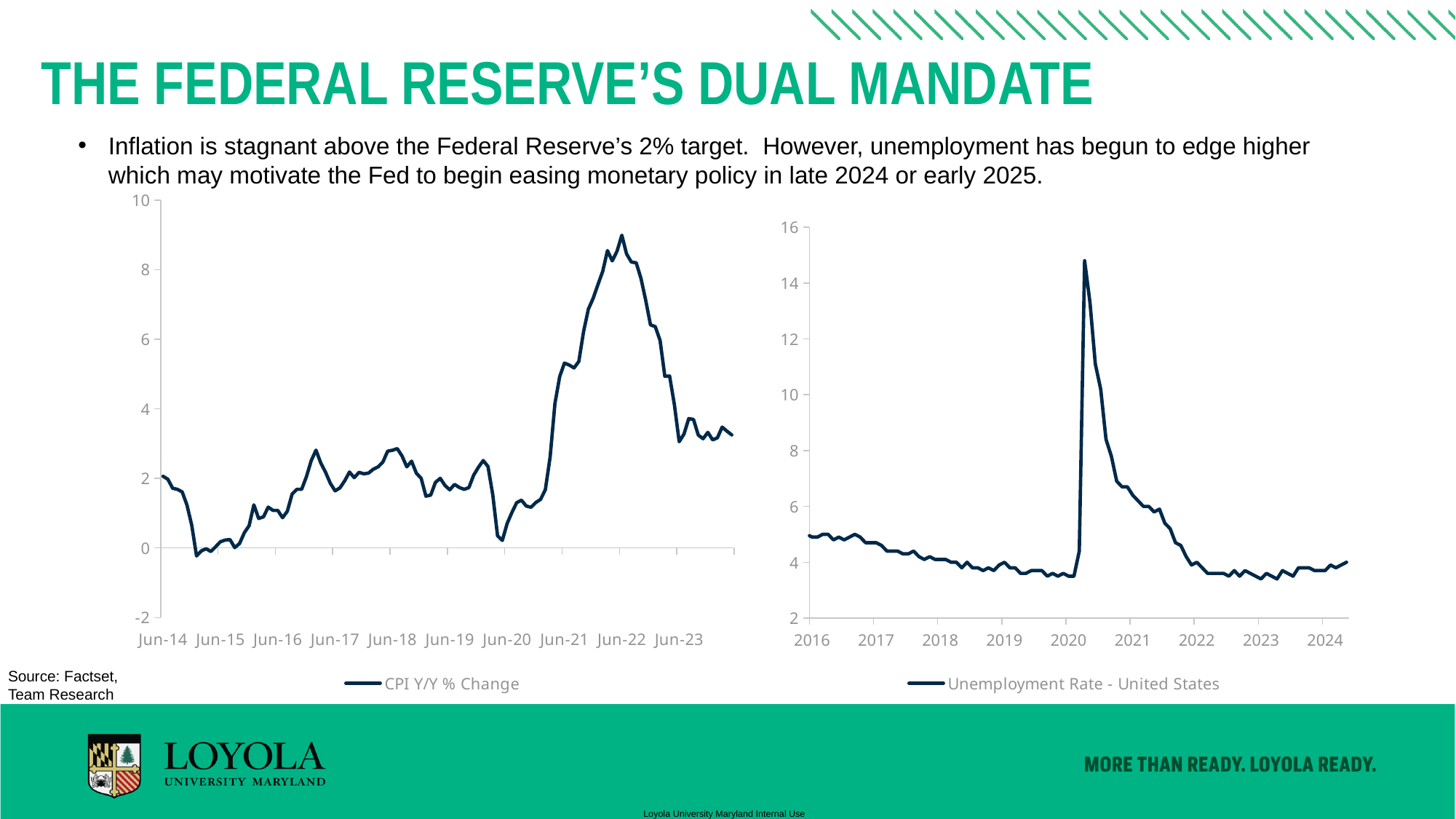
In the left chart (CPI Y/Y % Change), is the lowest value around Jun-20 greater or less than 2? less In the right chart (Unemployment Rate - United States), does the value rise or fall between 2016 and 2019? fall How many series does the legend of the left chart (CPI Y/Y % Change) list? 1 In the left chart (CPI Y/Y % Change), does the value rise or fall between Jun-21 and Jun-22? rise In the left chart (CPI Y/Y % Change), is the value at Jun-23 greater or less than 2? greater What is the legend entry of the right chart? Unemployment Rate - United States What kind of chart is the left chart, titled CPI Y/Y % Change? line chart In the right chart (Unemployment Rate - United States), is the value at the 2023 tick greater or less than 4? less What kind of chart is the right chart, titled Unemployment Rate - United States? line chart